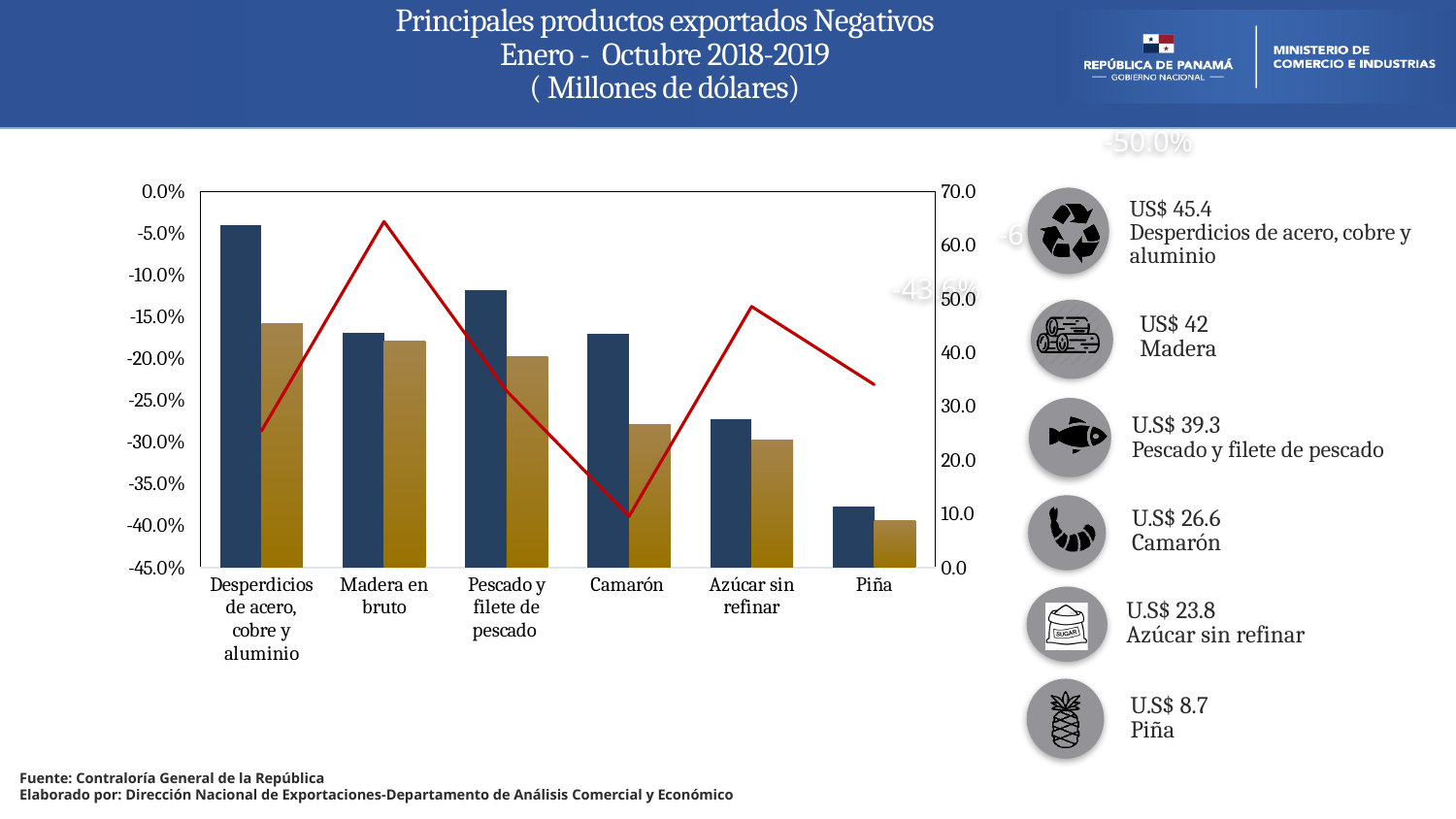
What is the title of the chart on the slide? Principales productos exportados Negativos Enero - Octubre 2018-2019 ( Millones de dólares) Which category has the tallest blue bar? Desperdicios de acero, cobre y aluminio What kind of chart is shown on the slide? bar chart with a line Is the blue bar for Piña greater or less than 20.0 on the right axis? less Which category has the shortest blue bar? Piña Which blue bar is taller, Pescado y filete de pescado or Madera en bruto? Pescado y filete de pescado Is the gold bar for Camarón greater or less than 30.0 on the right axis? less How many product categories are shown on the x axis of the chart? 6 At which category does the red line reach its highest point? Madera en bruto At which category does the red line reach its lowest point? Camarón Is the red line value for Camarón greater or less than -35.0% on the left axis? less